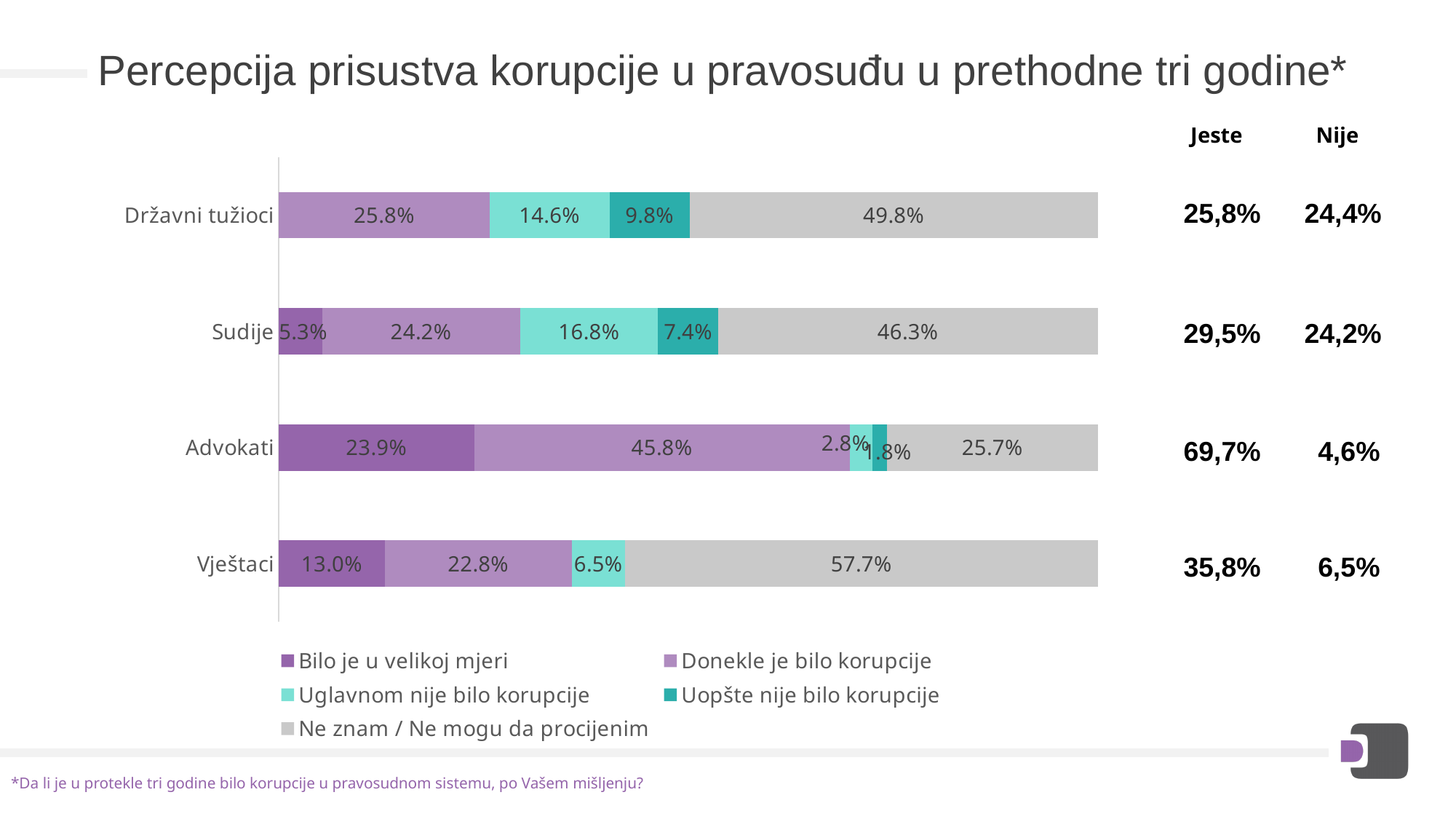
What kind of chart is shown on the slide? Stacked bar chart What is the value of "Donekle je bilo korupcije" for Advokati? 45.8% Which group has the lowest value for "Donekle je bilo korupcije"? Vještaci Which group has the highest share of "Ne znam / Ne mogu da procijenim"? Vještaci How many groups (categories) are shown on the chart? 4 How much larger is the "Uglavnom nije bilo korupcije" value for Sudije than for Državni tužioci? 2.2 percentage points Which has a larger "Uopšte nije bilo korupcije" value, Državni tužioci or Sudije? Državni tužioci How many series does the legend list? 5 What percentage of Vještaci answered "Ne znam / Ne mogu da procijenim"? 57.7% What is the combined share of "Bilo je u velikoj mjeri" and "Donekle je bilo korupcije" for Advokati? 69.7% What is the value of "Bilo je u velikoj mjeri" for Sudije? 5.3% Which legend entry is shown in grey? Ne znam / Ne mogu da procijenim